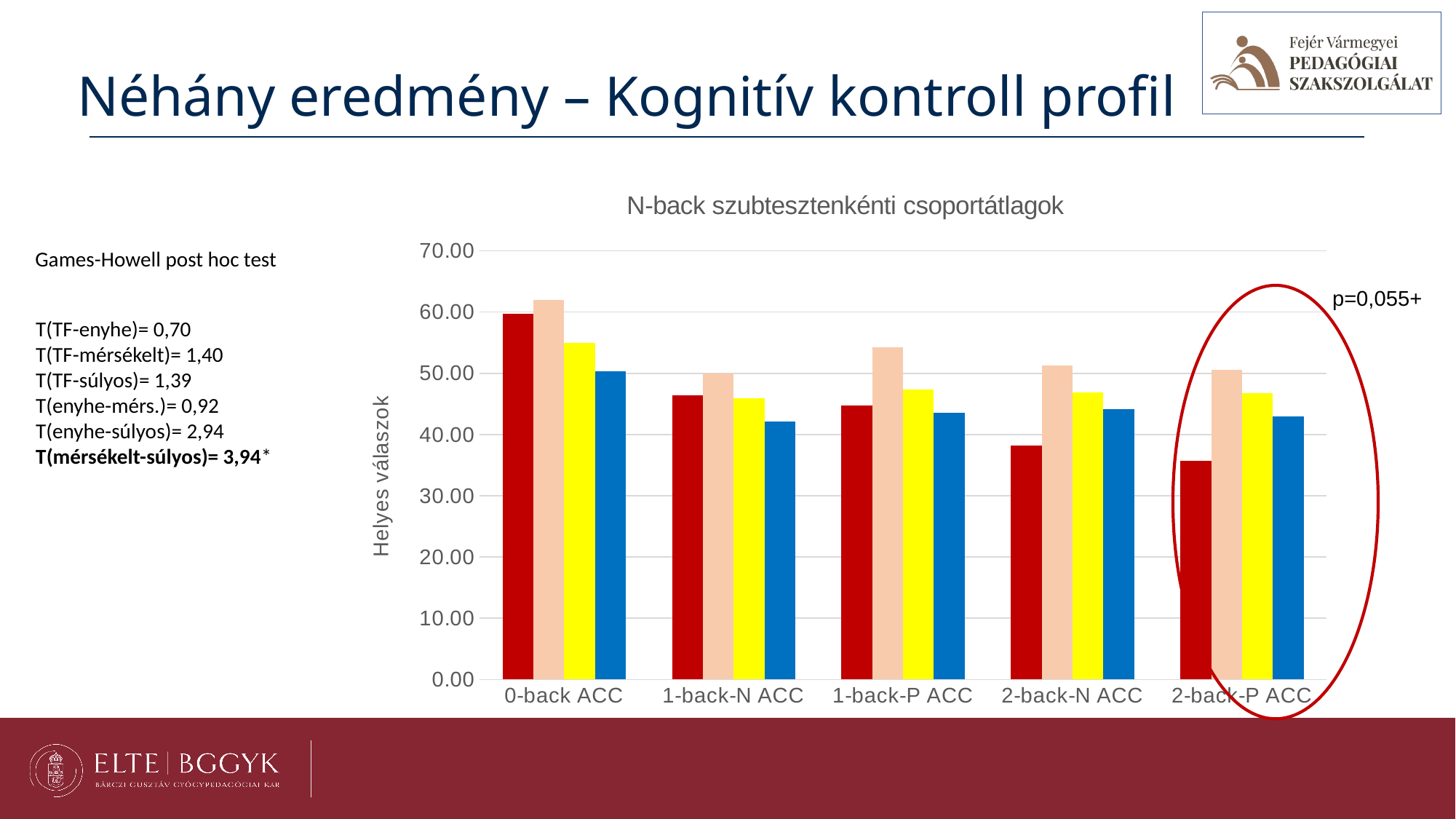
How many categories are shown on the x axis of the chart? 5 Is the value of the blue bar for 1-back-N ACC greater or less than 50? less What is the label of the vertical axis of the chart? Helyes válaszok Do the values of the red bars rise or fall from 0-back ACC to 2-back-P ACC? fall What is the title of the chart? N-back szubtesztenkénti csoportátlagok What kind of chart is shown on the slide? bar chart Is the value of the red bar for 2-back-P ACC greater or less than 40? less How many bars are shown for each category in the chart? 4 For which category is the red bar the highest? 0-back ACC Is the value of the yellow bar for 0-back ACC greater or less than 50? greater For which category is the red bar the lowest? 2-back-P ACC